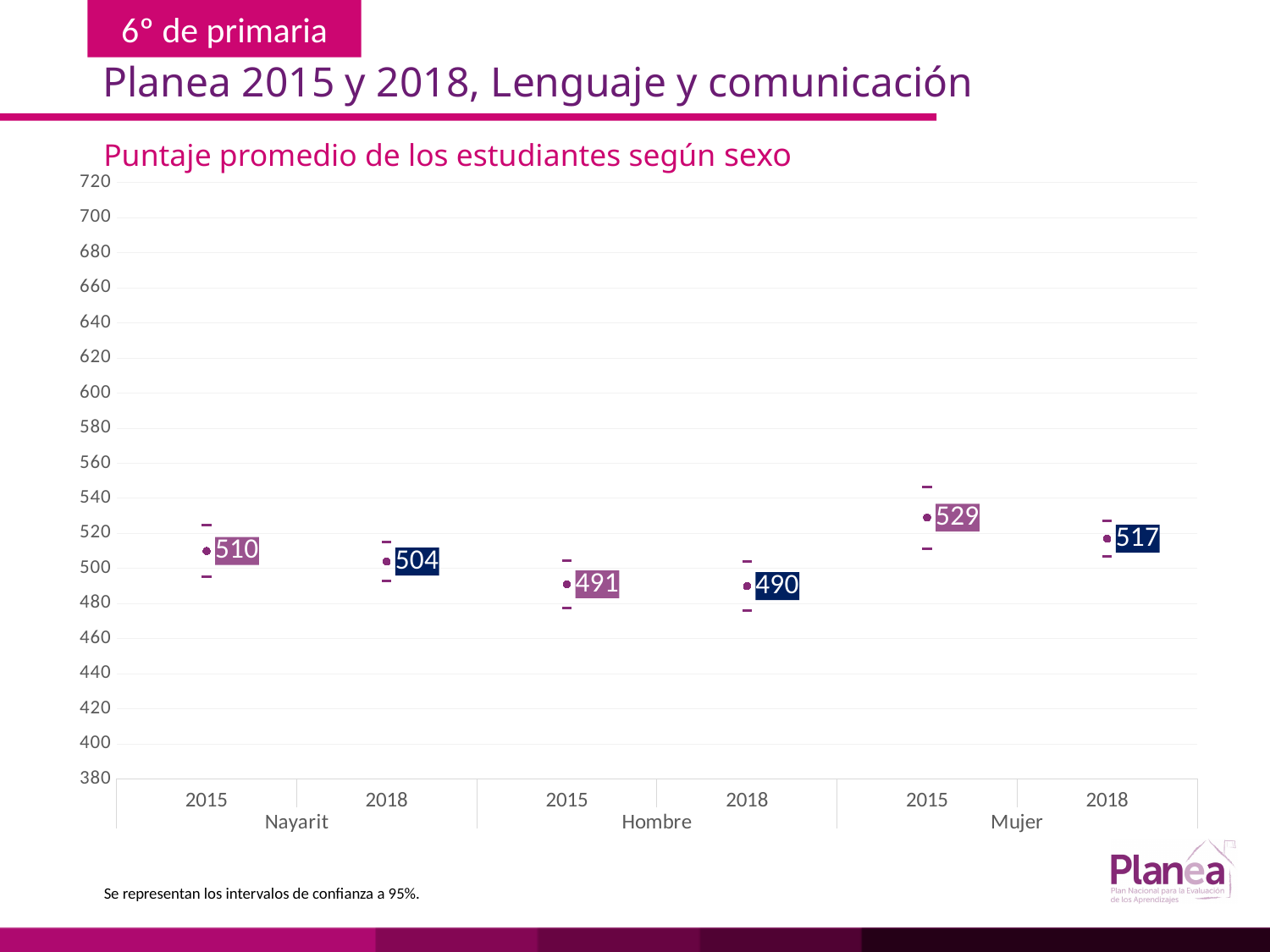
What is the average score for Nayarit in 2015? 510 What is the average score for Mujer in 2018? 517 What is the difference between the Mujer score in 2015 and in 2018? 12 Which group and year has the highest average score? Mujer 2015 Which group and year has the lowest average score? Hombre 2018 Did the Mujer average score rise or fall from 2015 to 2018? fall What is the average score for Hombre in 2018? 490 What is the title of the chart? Puntaje promedio de los estudiantes según sexo What is the difference between the Nayarit score in 2015 and in 2018? 6 Which is larger, the Hombre score in 2015 or the Nayarit score in 2018? Nayarit 2018 What is the average score for Mujer in 2015? 529